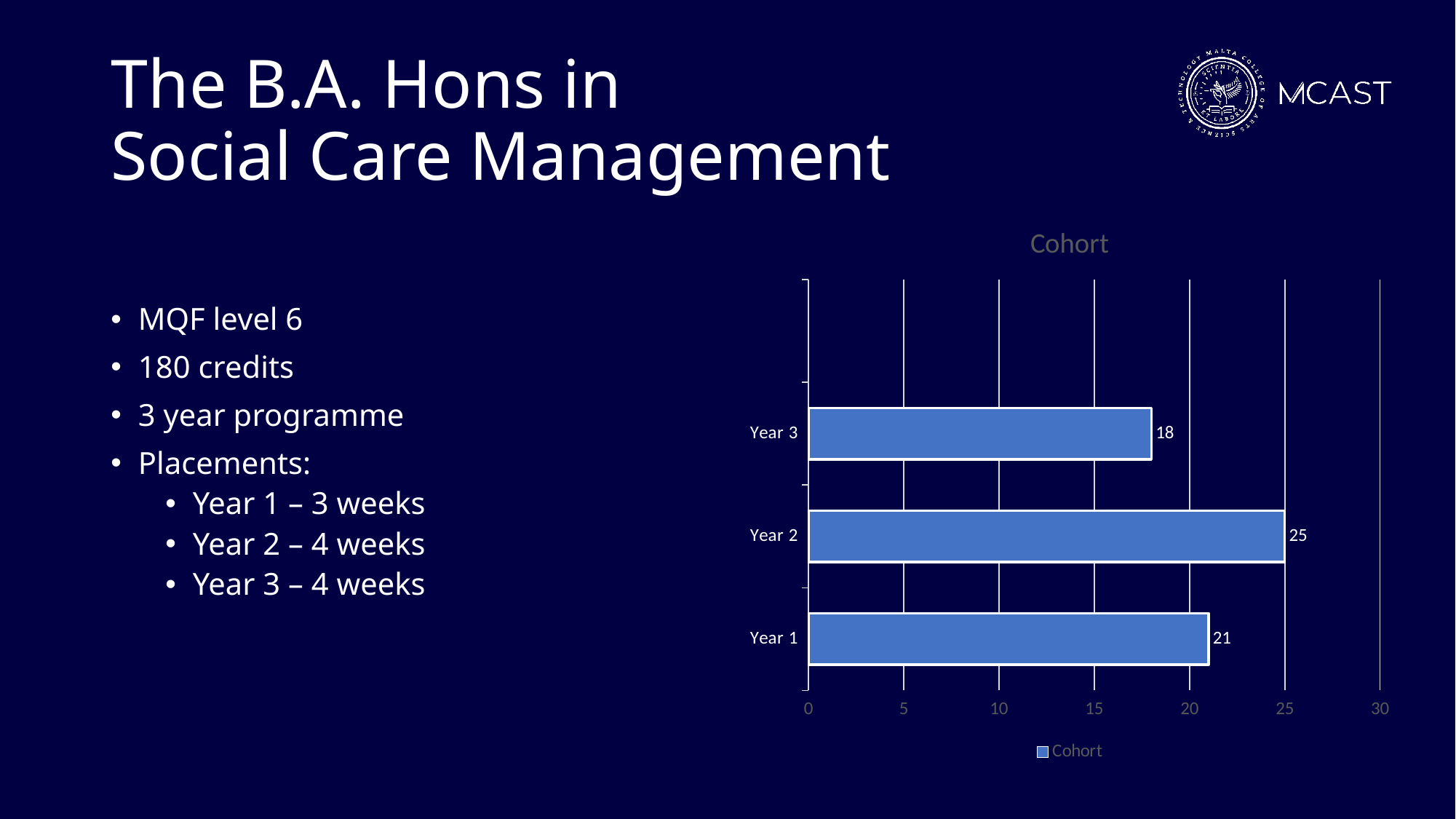
What is the difference between the Year 1 and Year 3 cohort values? 3 Which year has the largest cohort? Year 2 What is the difference between the Year 2 and Year 3 cohort values? 7 Which is larger, the cohort for Year 1 or Year 2? Year 2 What is the cohort value for Year 1? 21 What is the title of the chart? Cohort How many categories are shown in the chart? 3 What is the cohort value for Year 3? 18 Which year has the smallest cohort? Year 3 What is the cohort value for Year 2? 25 What kind of chart is shown on the slide? bar chart Is the cohort value for Year 3 greater or less than 20? less